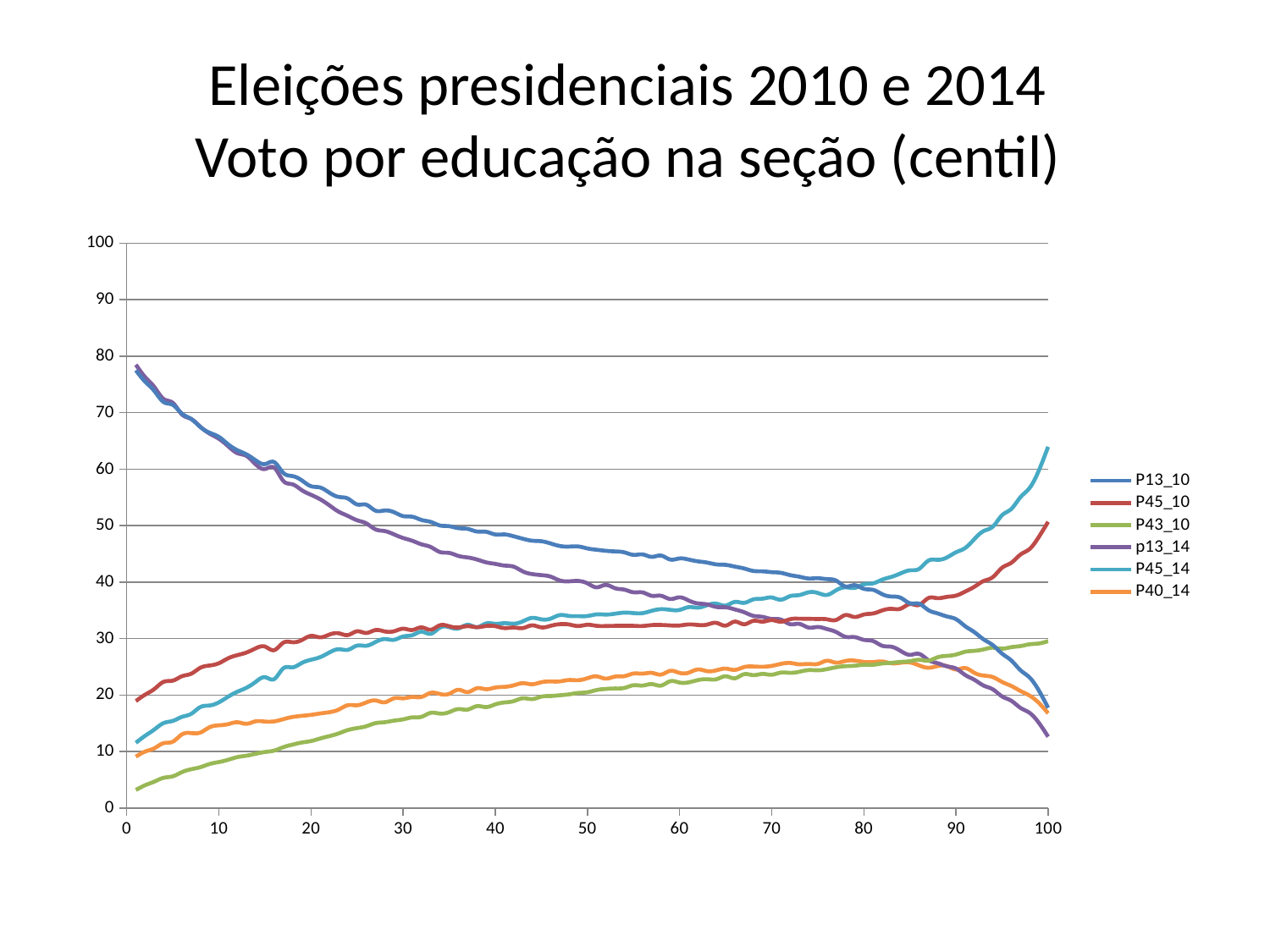
What kind of chart is shown on the slide? line chart Is the value of P45_14 at x = 100 greater or less than 60? greater Is the value of p13_14 at x = 100 greater or less than 20? less At x = 100, which series has the larger value, P45_14 or P45_10? P45_14 Does the P45_14 series rise or fall as the x axis goes from 0 to 100? rise Which series has the highest value at x = 100? P45_14 At x = 10, which series has the larger value, P13_10 or P45_10? P13_10 How many series does the legend list? 6 Does the P13_10 series rise or fall as the x axis goes from 0 to 100? fall Is the value of P40_14 at x = 50 greater or less than 30? less Which series is drawn in green in the legend? P43_10